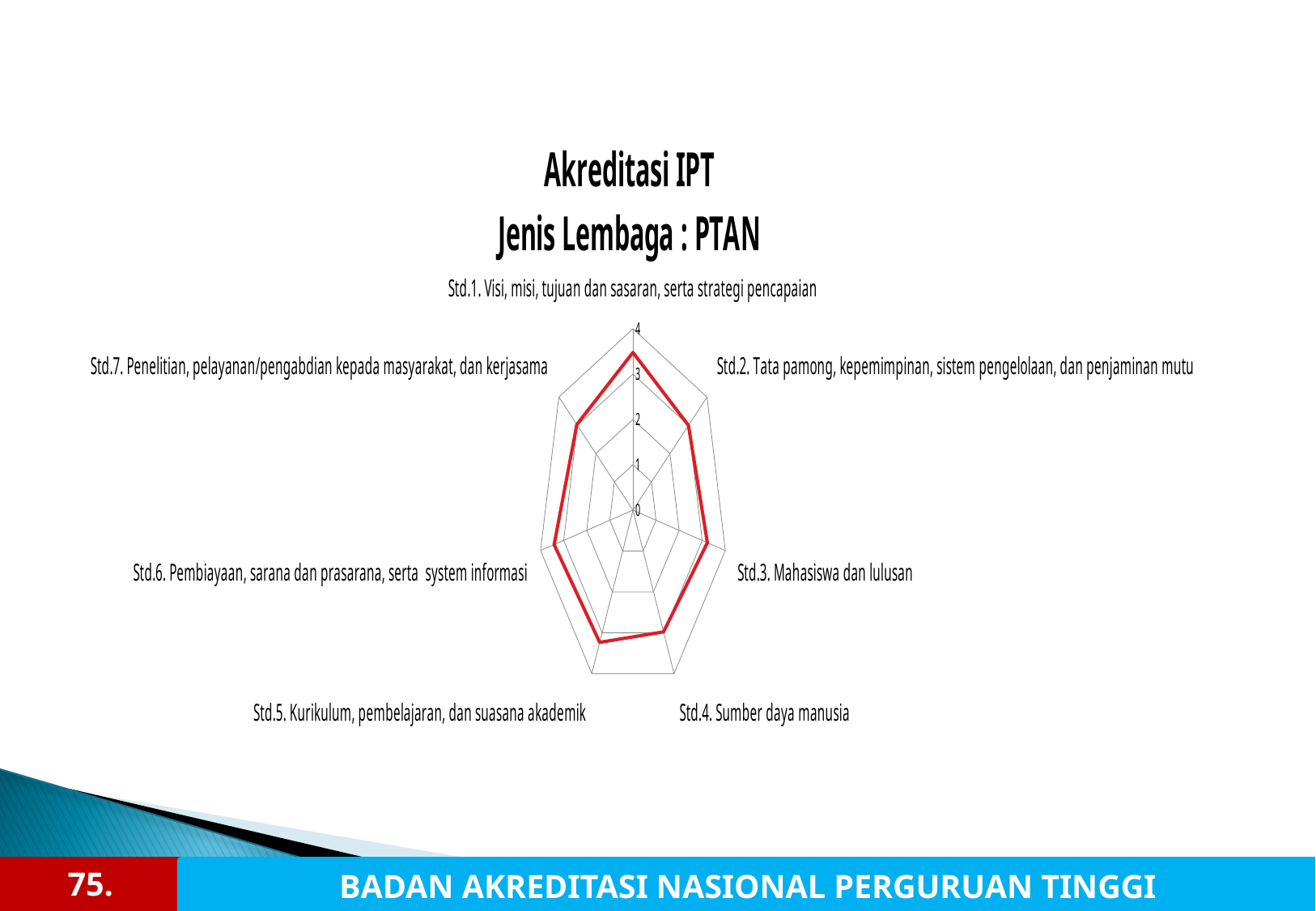
Is the value for Std.1 (Visi, misi, tujuan dan sasaran, serta strategi pencapaian) greater or less than 3? greater Is the value for Std.2 (Tata pamong, kepemimpinan, sistem pengelolaan, dan penjaminan mutu) greater or less than 2? greater Is the value for Std.6 (Pembiayaan, sarana dan prasarana, serta system informasi) greater or less than 3? greater What kind of chart is shown on the slide? radar chart What is the title of the chart? Akreditasi IPT Jenis Lembaga : PTAN How many standards (categories) are plotted on the radar chart? 7 What is the maximum value shown on the chart's axis scale? 4